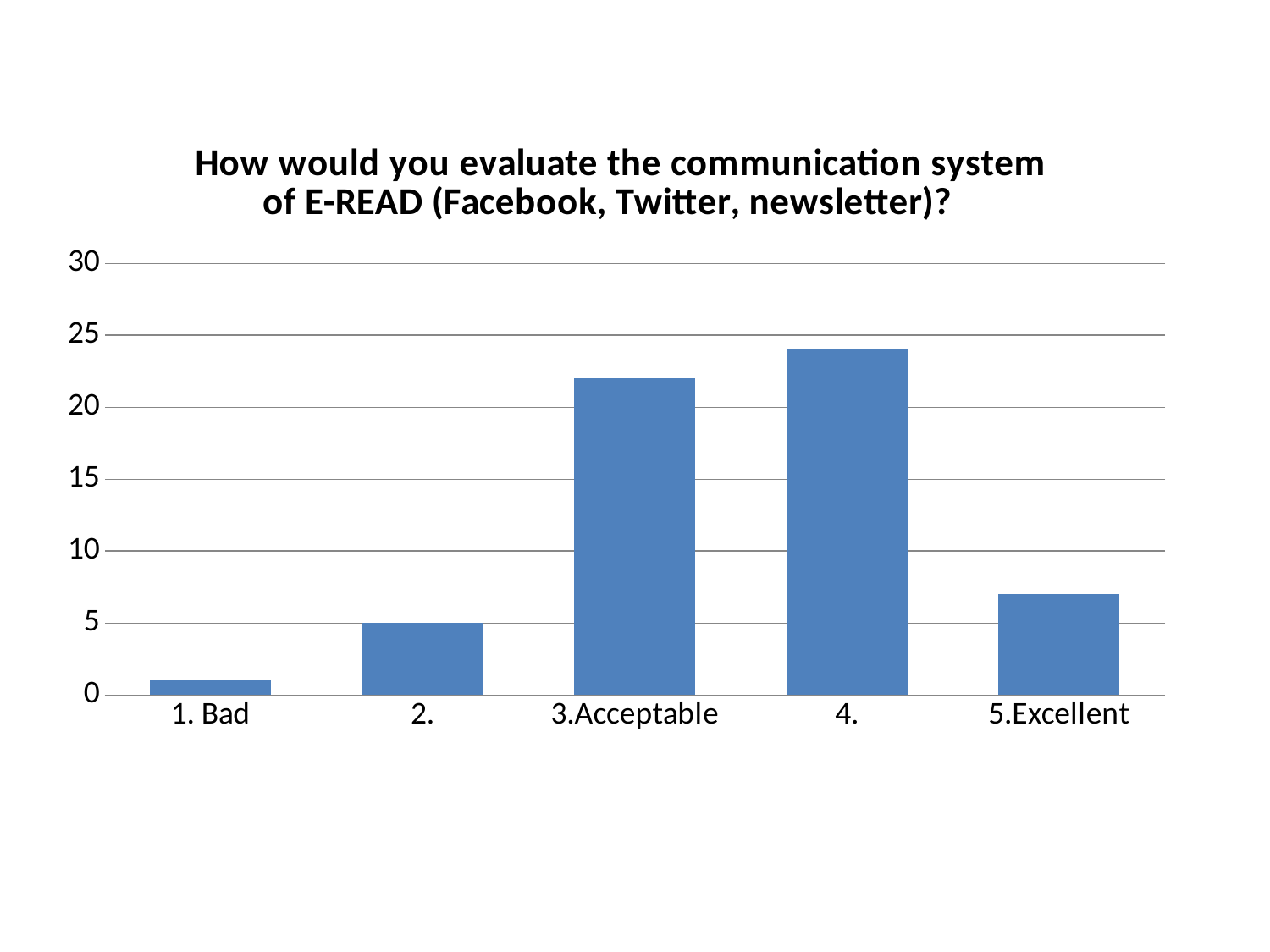
Is the value for 1. Bad greater or less than 5? less Which is larger, the value for 3.Acceptable or the value for 5.Excellent? 3.Acceptable Is the value for 3.Acceptable greater or less than 20? greater What kind of chart is shown on the slide? bar chart How many categories are shown on the x axis of the chart? 5 Is the value for 5.Excellent greater or less than 5? greater Which is larger, the value for 4. or the value for 3.Acceptable? 4. Which category has the highest bar in the chart? 4. Which category has the lowest bar in the chart? 1. Bad What is the title of the chart? How would you evaluate the communication system of E-READ (Facebook, Twitter, newsletter)? What is the value for the category "2."? 5